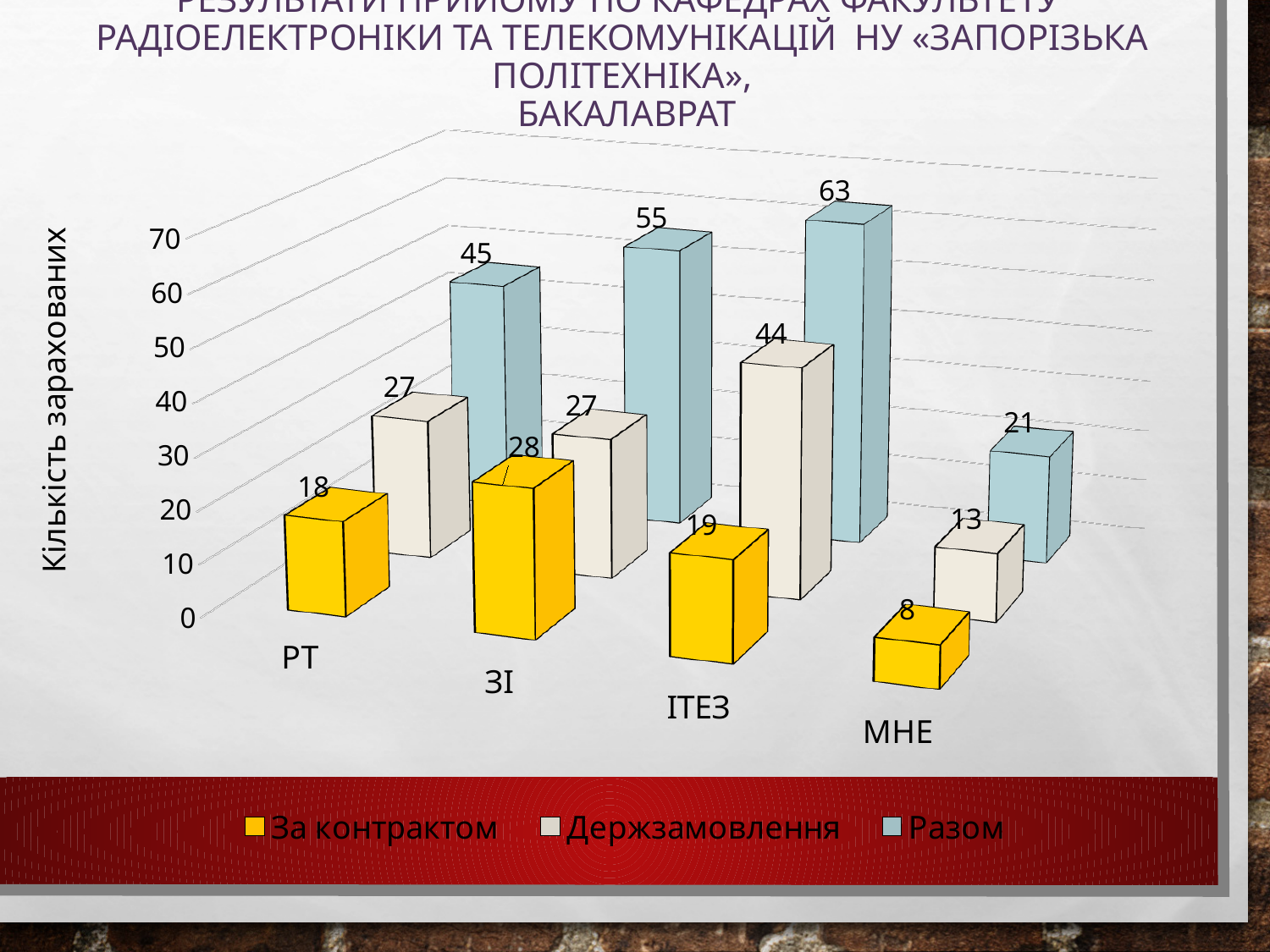
What kind of chart is shown on the slide? bar chart What is the Разом value for МНЕ? 21 How many series does the legend list? 3 What is the difference between the Разом values for ІТЕЗ and РТ? 18 Which category has the lowest За контрактом value? МНЕ Which is larger: the Держзамовлення value for ІТЕЗ or the Держзамовлення value for ЗІ? ІТЕЗ What is the value for ЗІ in the За контрактом series? 28 How many categories are shown on the x axis? 4 Which series is shown in yellow? За контрактом What is the value for ІТЕЗ in the Держзамовлення series? 44 What is the label of the vertical axis? Кількість зарахованих Which category has the highest Разом value? ІТЕЗ